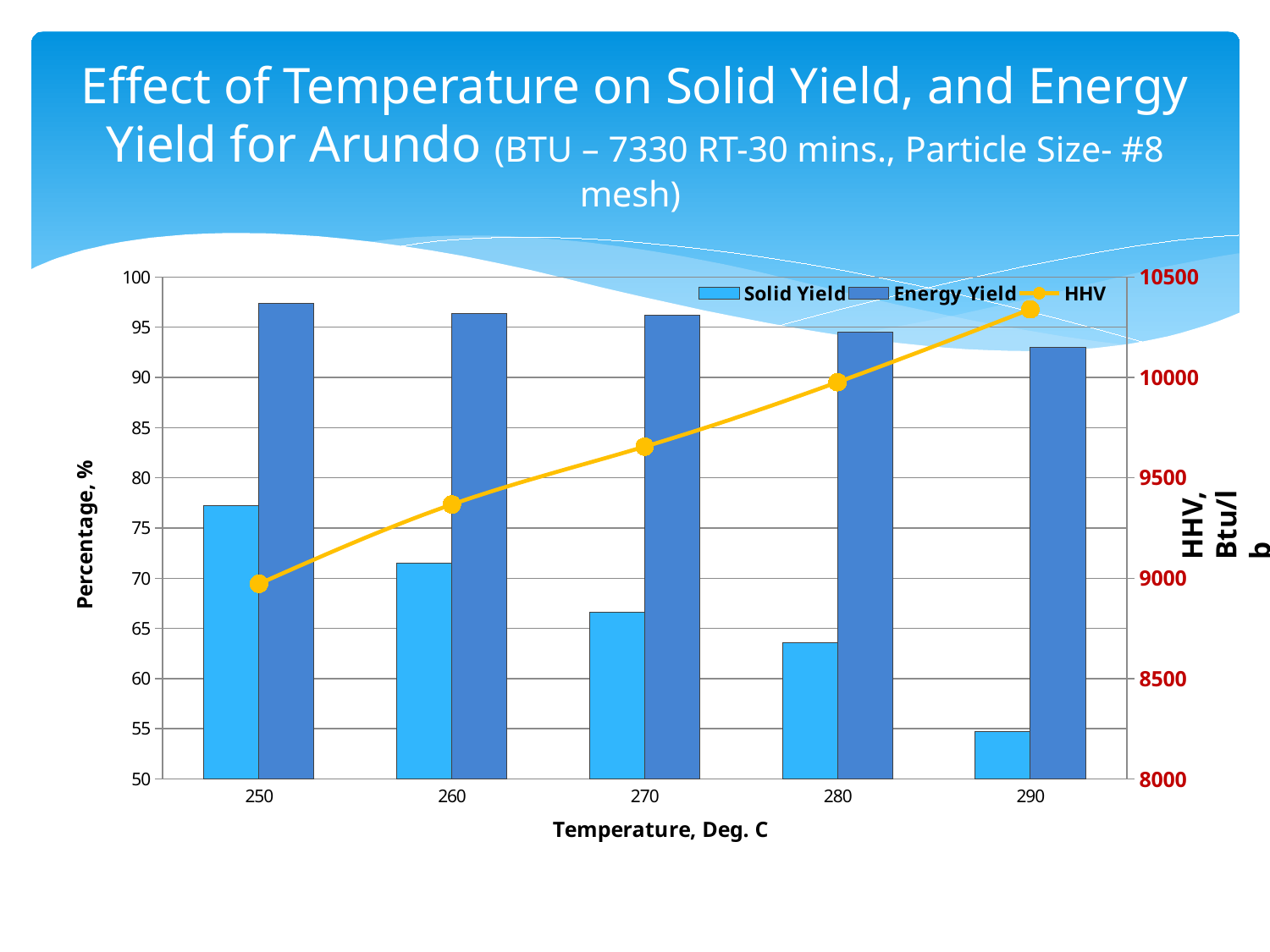
How many series does the legend list? 3 Is the HHV at 260 greater or less than 9500? less Is the Solid Yield at 250 greater or less than 75? greater At which temperature is Solid Yield highest? 250 Does Solid Yield rise or fall as temperature increases from 250 to 290? fall Is the HHV at 290 greater or less than 10000? greater How many temperature categories are plotted on the x axis? 5 At which temperature is Solid Yield lowest? 290 At which temperature is Energy Yield lowest? 290 Does HHV rise or fall as temperature increases from 250 to 290? rise What kind of chart is shown on the slide? A bar chart with a line series